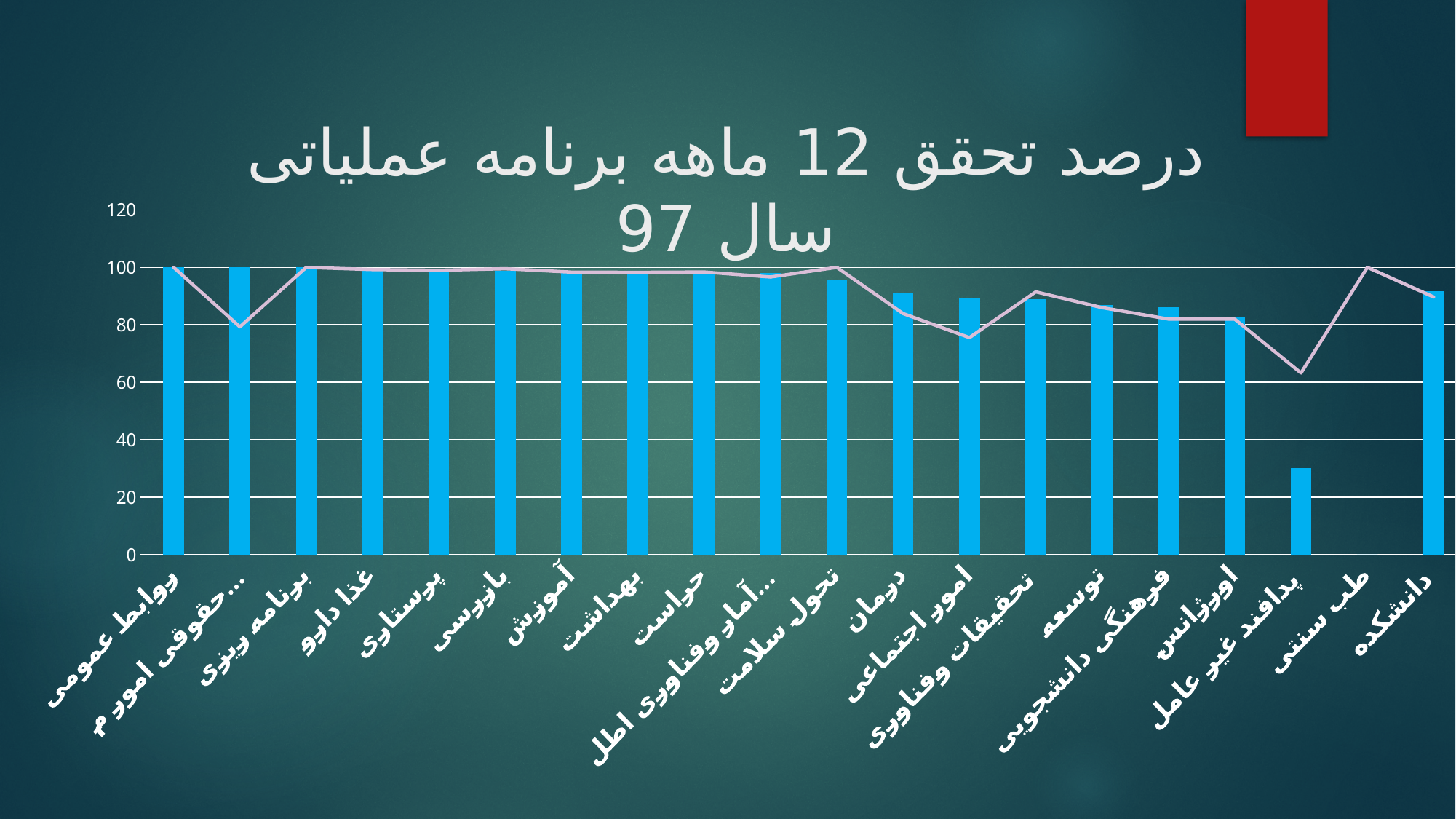
Do the bar values generally rise or fall from روابط عمومی to اورژانس along the x axis? fall What is the title of the chart? درصد تحقق 12 ماهه برنامه عملیاتی سال 97 How many categories are shown on the x axis of the chart? 20 Which has the larger value, روابط عمومی or اورژانس? روابط عمومی Is the value for پدافند غیر عامل greater or less than 20? greater Is the value for روابط عمومی greater or less than 80? greater Is the value for اورژانس greater or less than 60? greater Which has the larger value, بهداشت or توسعه? بهداشت Which has the larger value, پدافند غیر عامل or دانشکده? دانشکده What kind of chart is shown on the slide? bar chart with a line overlay